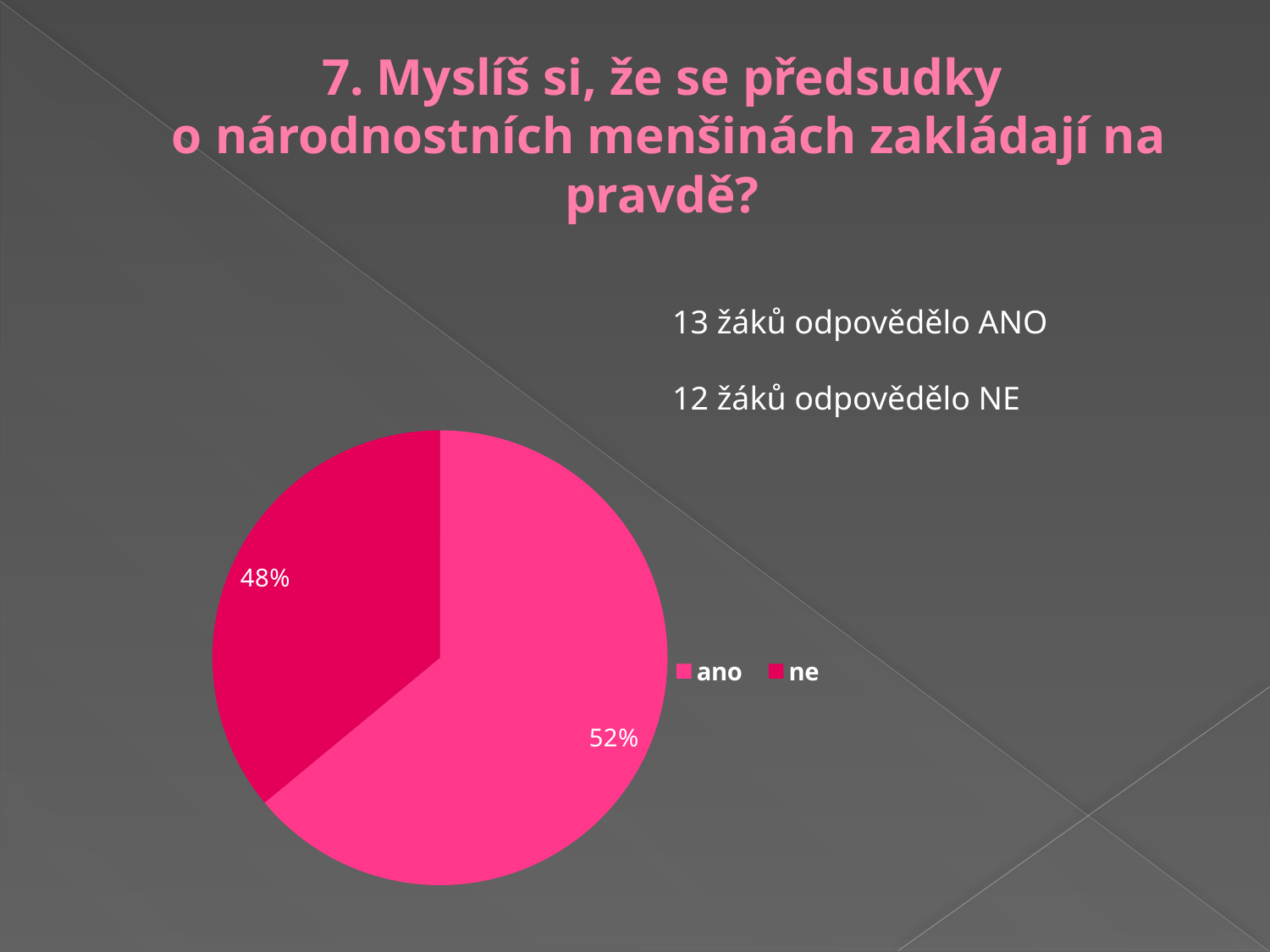
What are the two legend entries of the pie chart? ano, ne Is the share of the "ano" slice greater or less than 50%? greater Which legend entry is shown in the darker pink colour? ne Which slice is the smallest in the pie chart? ne What kind of chart is shown on the slide? pie chart What percentage of the pie does the "ano" slice represent? 52% How many entries does the legend list? 2 Which slice is the largest in the pie chart? ano How many slices does the pie chart have? 2 What is the difference in percentage points between the "ano" and "ne" slices? 4 Which slice is larger, "ano" or "ne"? ano What percentage of the pie does the "ne" slice represent? 48%